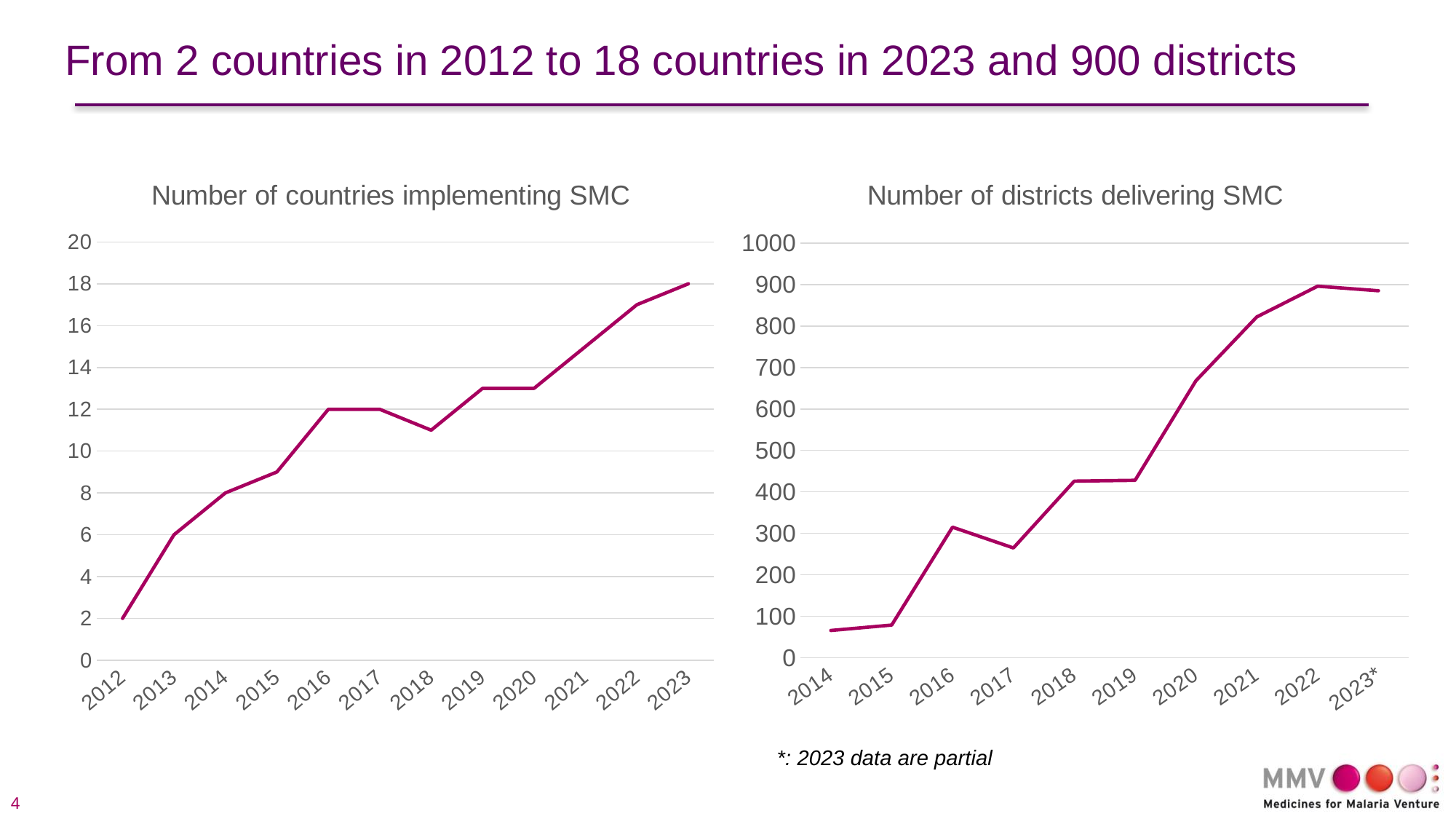
In the chart titled "Number of countries implementing SMC", what is the value for 2012? 2 In the chart titled "Number of districts delivering SMC", is the value for 2021 larger or smaller than the value for 2019? larger In the chart titled "Number of countries implementing SMC", what is the value for 2023? 18 In the chart titled "Number of countries implementing SMC", what is the value for 2016? 12 In the chart titled "Number of countries implementing SMC", which year has the highest value? 2023 In the chart titled "Number of countries implementing SMC", how many years are shown on the x axis? 12 What kind of chart is the chart titled "Number of districts delivering SMC"? line chart In the chart titled "Number of countries implementing SMC", which year has the lowest value? 2012 In the chart titled "Number of countries implementing SMC", what is the difference between the values for 2023 and 2012? 16 In the chart titled "Number of districts delivering SMC", is the value for 2017 greater or less than 300? less In the chart titled "Number of districts delivering SMC", which year has the lowest value? 2014 In the chart titled "Number of districts delivering SMC", is the value for 2020 greater or less than 600? greater